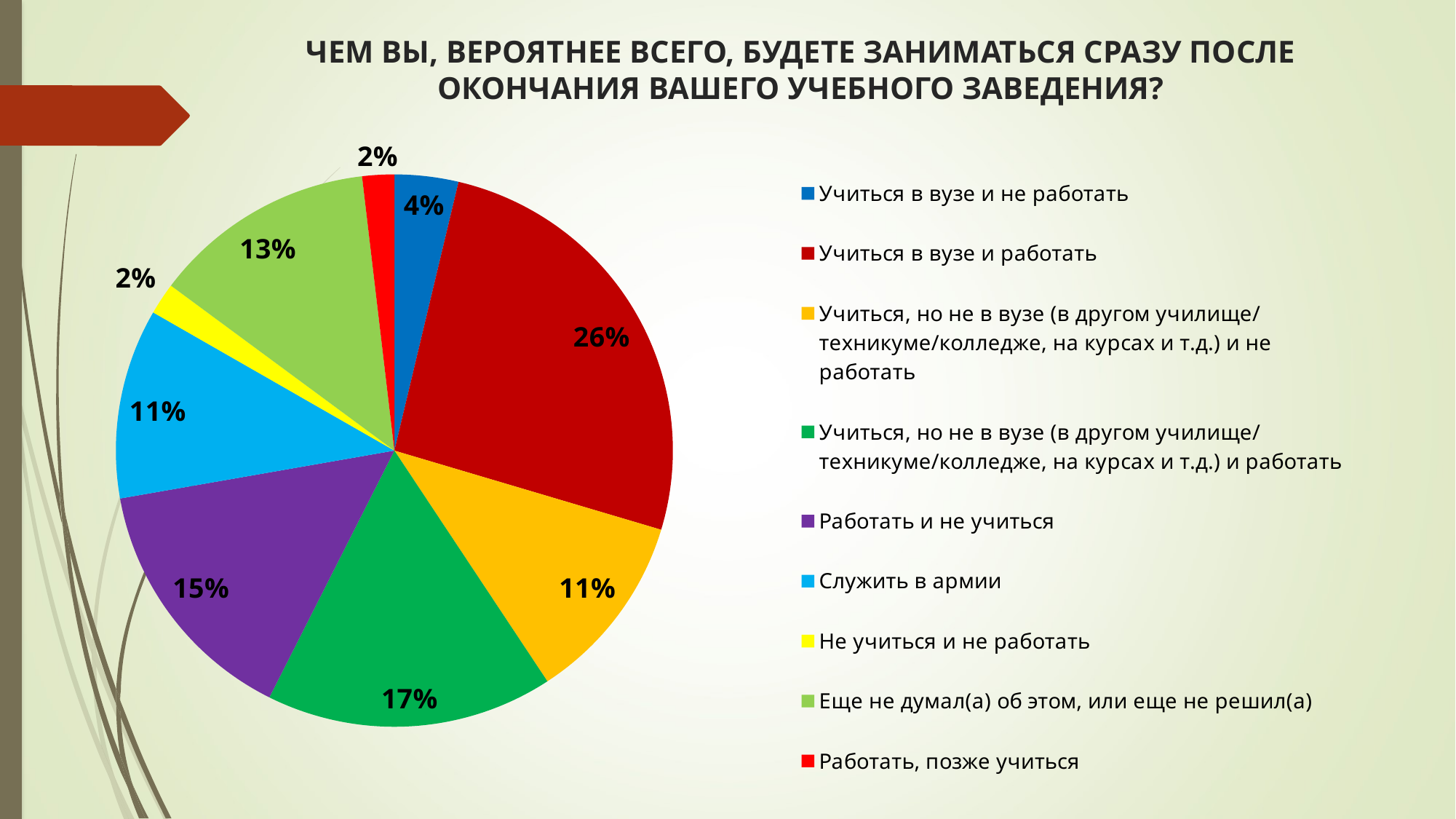
How many categories does the legend list? 9 What colour is the slice for 'Служить в армии'? light blue What is the value for 'Не учиться и не работать'? 2% What is the difference between 'Учиться в вузе и работать' and 'Учиться, но не в вузе (в другом училище/техникуме/колледже, на курсах и т.д.) и работать'? 9% What is the value for 'Еще не думал(а) об этом, или еще не решил(а)'? 13% What is the value for 'Служить в армии'? 11% Which is larger: 'Работать и не учиться' or 'Еще не думал(а) об этом, или еще не решил(а)'? Работать и не учиться What share of the pie is 'Учиться в вузе и работать'? 26% What is the value for 'Учиться в вузе и не работать'? 4% What is the value for 'Работать и не учиться'? 15% Which category has the largest slice of the pie? Учиться в вузе и работать What kind of chart is shown on the slide? pie chart